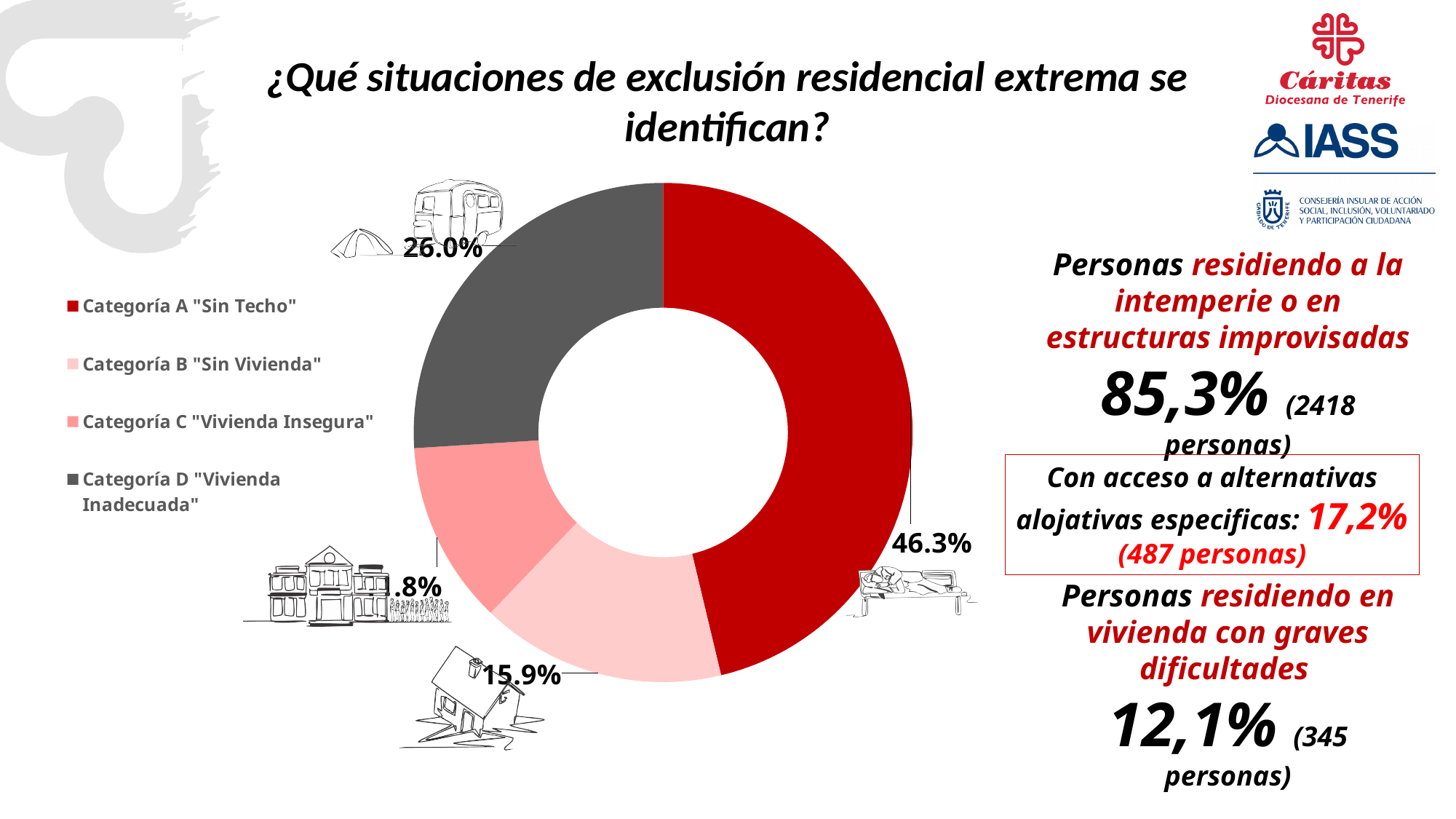
What is the difference in percentage points between Categoría A "Sin Techo" and Categoría D "Vivienda Inadecuada"? 20.3 percentage points Which category has the largest slice of the chart? Categoría A "Sin Techo" What colour represents Categoría D "Vivienda Inadecuada" in the chart? Dark grey What percentage does the chart show for Categoría A "Sin Techo"? 46.3% Which category has the smallest slice of the chart? Categoría C "Vivienda Insegura" What percentage does the chart show for Categoría D "Vivienda Inadecuada"? 26.0% What is the difference in percentage points between Categoría D "Vivienda Inadecuada" and Categoría B "Sin Vivienda"? 10.1 percentage points Which is larger, the slice for Categoría D "Vivienda Inadecuada" or the slice for Categoría B "Sin Vivienda"? Categoría D "Vivienda Inadecuada" What kind of chart is shown on the slide? Pie chart (donut) How many entries does the chart legend list? 4 What percentage does the chart show for Categoría B "Sin Vivienda"? 15.9% How many categories are shown in the chart? 4